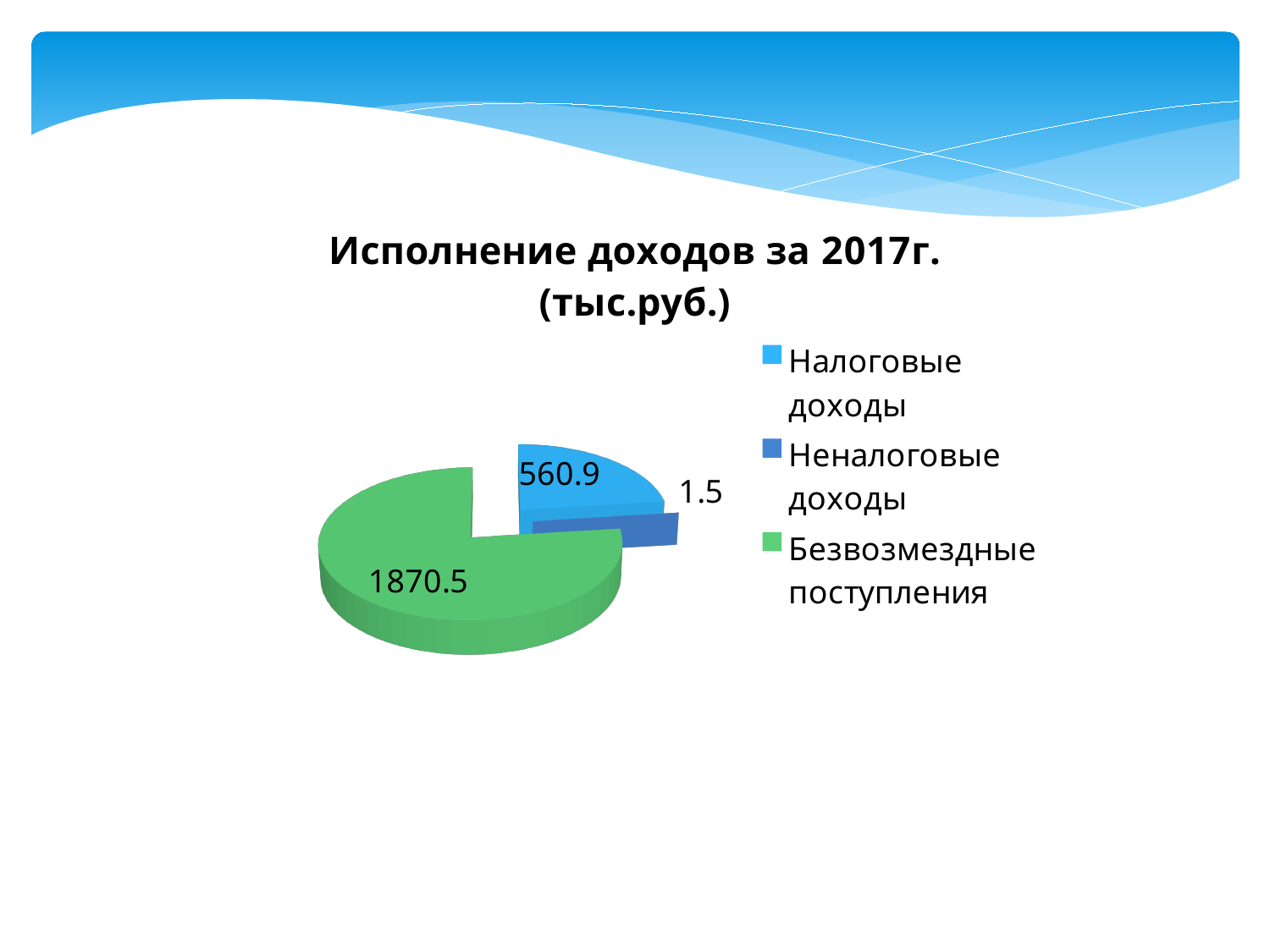
What is the title of the chart? Исполнение доходов за 2017г. (тыс.руб.) Which category has the largest slice of the pie? Безвозмездные поступления Which category has the smallest slice of the pie? Неналоговые доходы What is the difference between the values for Безвозмездные поступления and Налоговые доходы? 1309.6 What is the total of all three slices? 2432.9 What is the difference between the values for Налоговые доходы and Неналоговые доходы? 559.4 How many slices does the pie chart have? 3 What is the value for Неналоговые доходы? 1.5 What is the value for Налоговые доходы? 560.9 Which is larger, Налоговые доходы or Неналоговые доходы? Налоговые доходы What type of chart is shown on the slide? Pie chart What is the value for Безвозмездные поступления? 1870.5